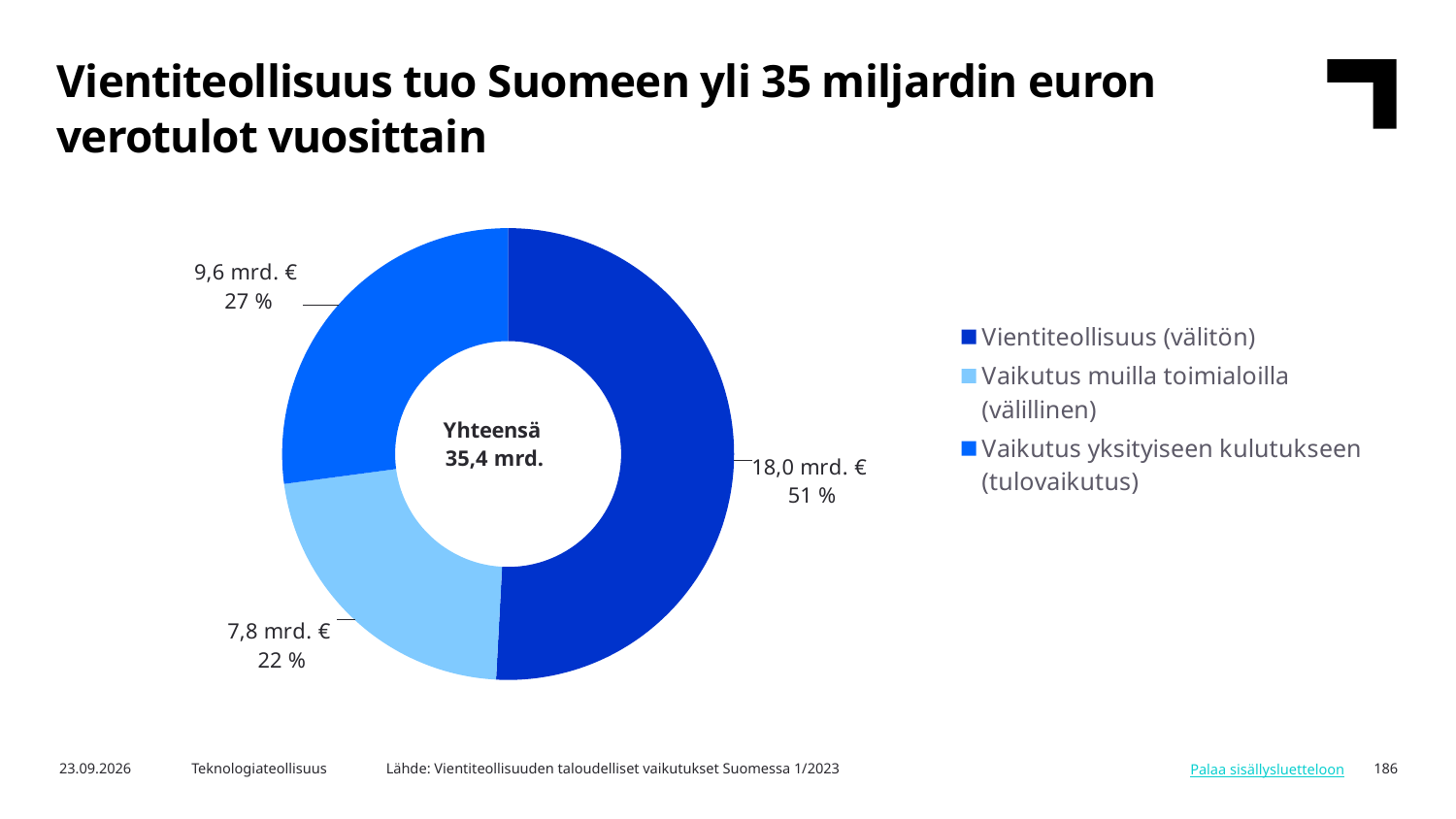
What total is printed in the centre of the donut chart? Yhteensä 35,4 mrd. What is the value for Vaikutus muilla toimialoilla (välillinen)? 7,8 mrd. € What share of the pie does Vaikutus muilla toimialoilla (välillinen) represent? 22 % What share of the pie does Vientiteollisuus (välitön) represent? 51 % What is the value for Vientiteollisuus (välitön)? 18,0 mrd. € How many categories does the chart show? 3 Which category has the largest slice? Vientiteollisuus (välitön) What kind of chart is shown on the slide? Pie (donut) chart Which category has the smallest slice? Vaikutus muilla toimialoilla (välillinen) What is the value for Vaikutus yksityiseen kulutukseen (tulovaikutus)? 9,6 mrd. € Which is larger, the value for Vaikutus yksityiseen kulutukseen (tulovaikutus) or Vaikutus muilla toimialoilla (välillinen)? Vaikutus yksityiseen kulutukseen (tulovaikutus) What is the difference between the values for Vientiteollisuus (välitön) and Vaikutus yksityiseen kulutukseen (tulovaikutus)? 8,4 mrd. €